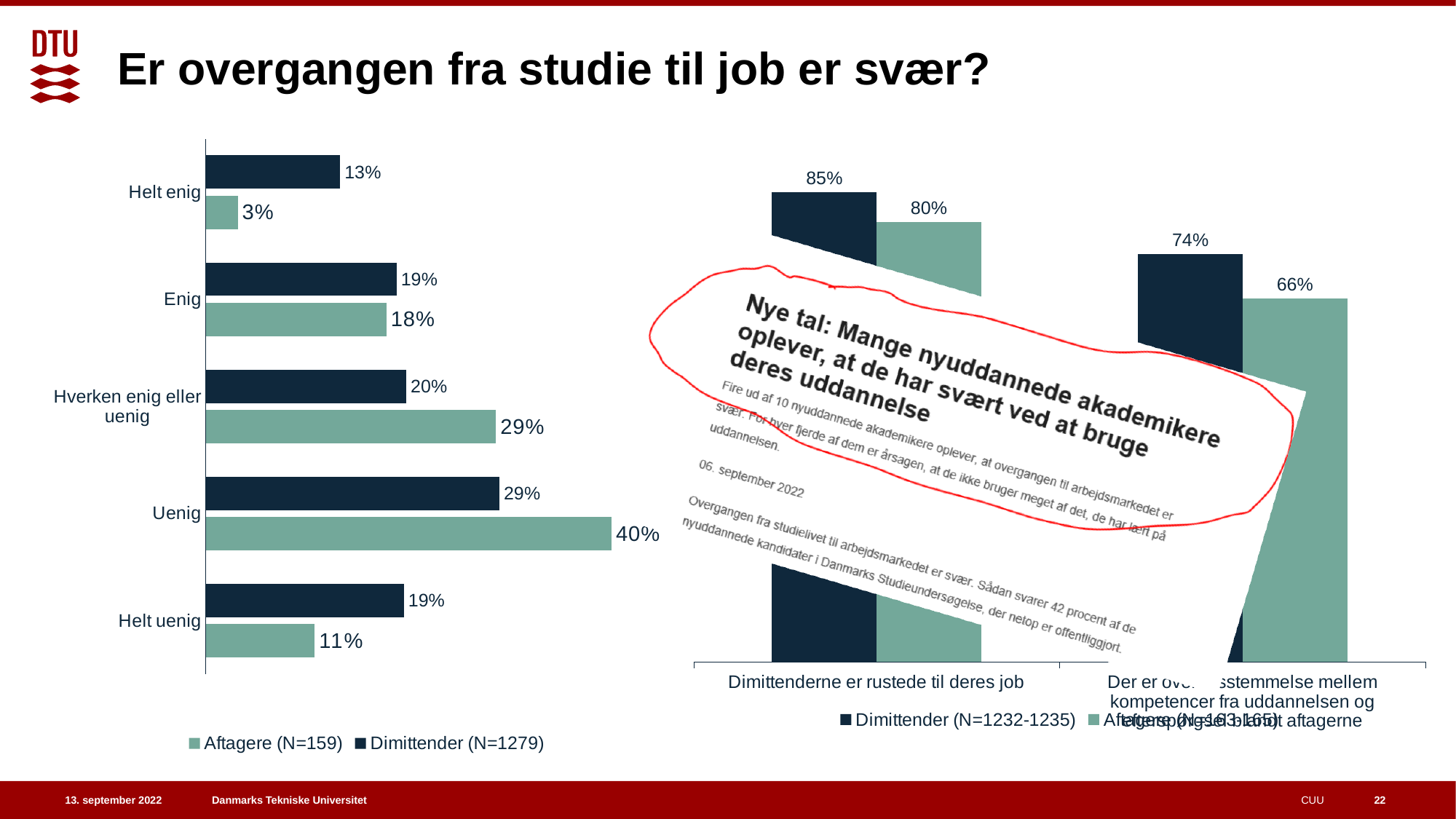
On the right chart, what is the Dimittender value for 'Dimittenderne er rustede til deres job'? 85% On the left chart, which category has the highest value for Aftagere? Uenig On the right chart, what is the Aftagere value for the right-hand category? 66% On the left chart, which category has the lowest value for Dimittender? Helt enig How many categories does the left chart show? 5 What type of chart is the left chart? Bar chart On the left chart, what is the value for Dimittender for 'Uenig'? 29% On the left chart, which is larger for 'Helt uenig': Aftagere or Dimittender? Dimittender On the left chart, what is the difference between the Aftagere and Dimittender values for 'Uenig'? 11% On the right chart, what is the difference between the Dimittender and Aftagere values for 'Dimittenderne er rustede til deres job'? 5% On the left chart, what is the value for Aftagere for 'Hverken enig eller uenig'? 29% On the left chart, what is the value for Aftagere for 'Helt enig'? 3%